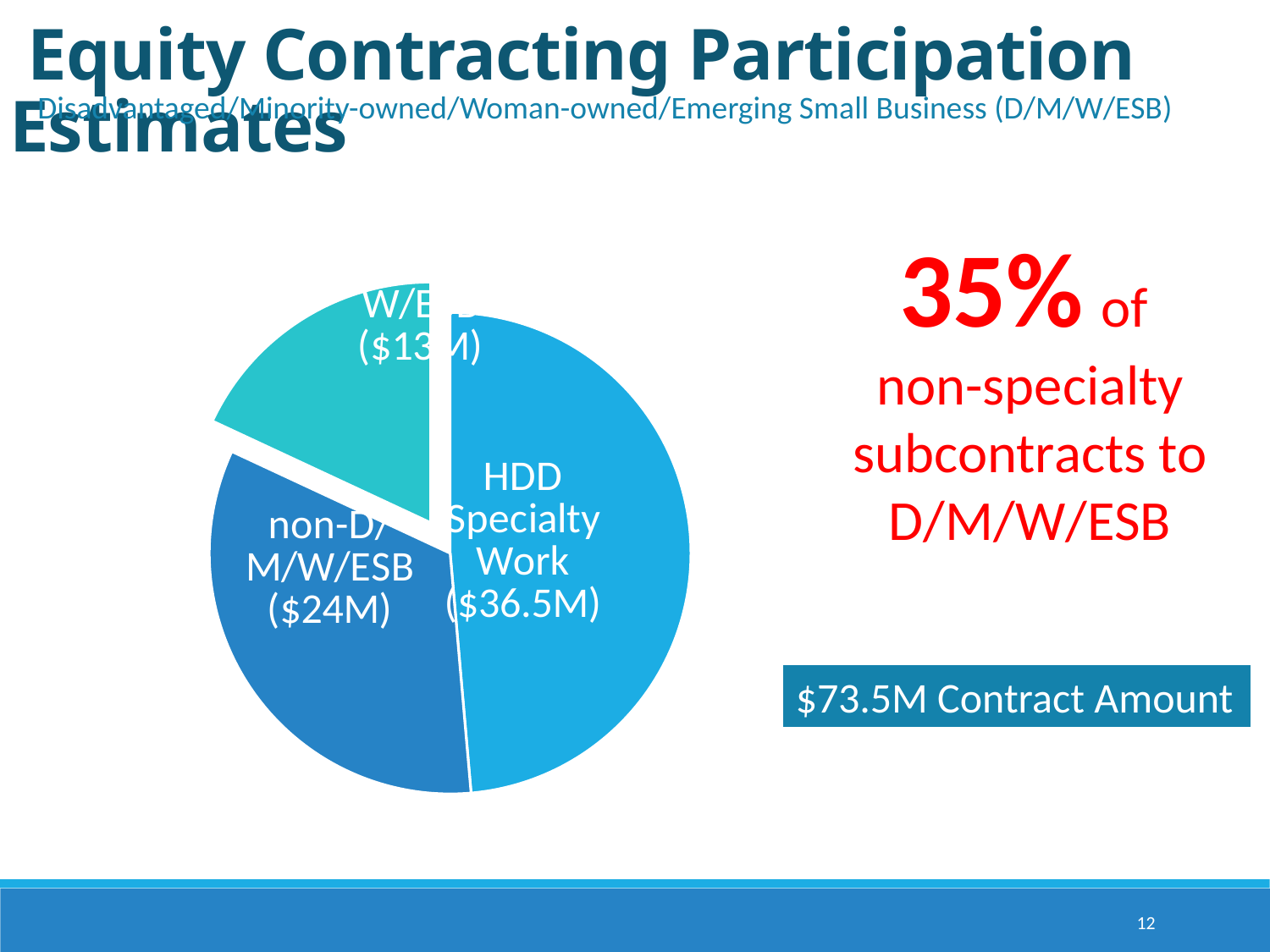
What is the difference between the HDD Specialty Work value and the non-D/M/W/ESB value? $12.5M Which is larger, HDD Specialty Work or non-D/M/W/ESB? HDD Specialty Work What value is labelled on the teal slice that is pulled away from the rest of the pie? $13M What total contract amount is stated on the slide? $73.5M What is the value shown for non-D/M/W/ESB in the pie chart? $24M How many slices does the pie chart have? 3 Which slice of the pie chart is the largest? HDD Specialty Work What percentage of non-specialty subcontracts is stated to go to D/M/W/ESB? 35% What is the value shown for HDD Specialty Work in the pie chart? $36.5M What kind of chart is shown on the slide? pie chart